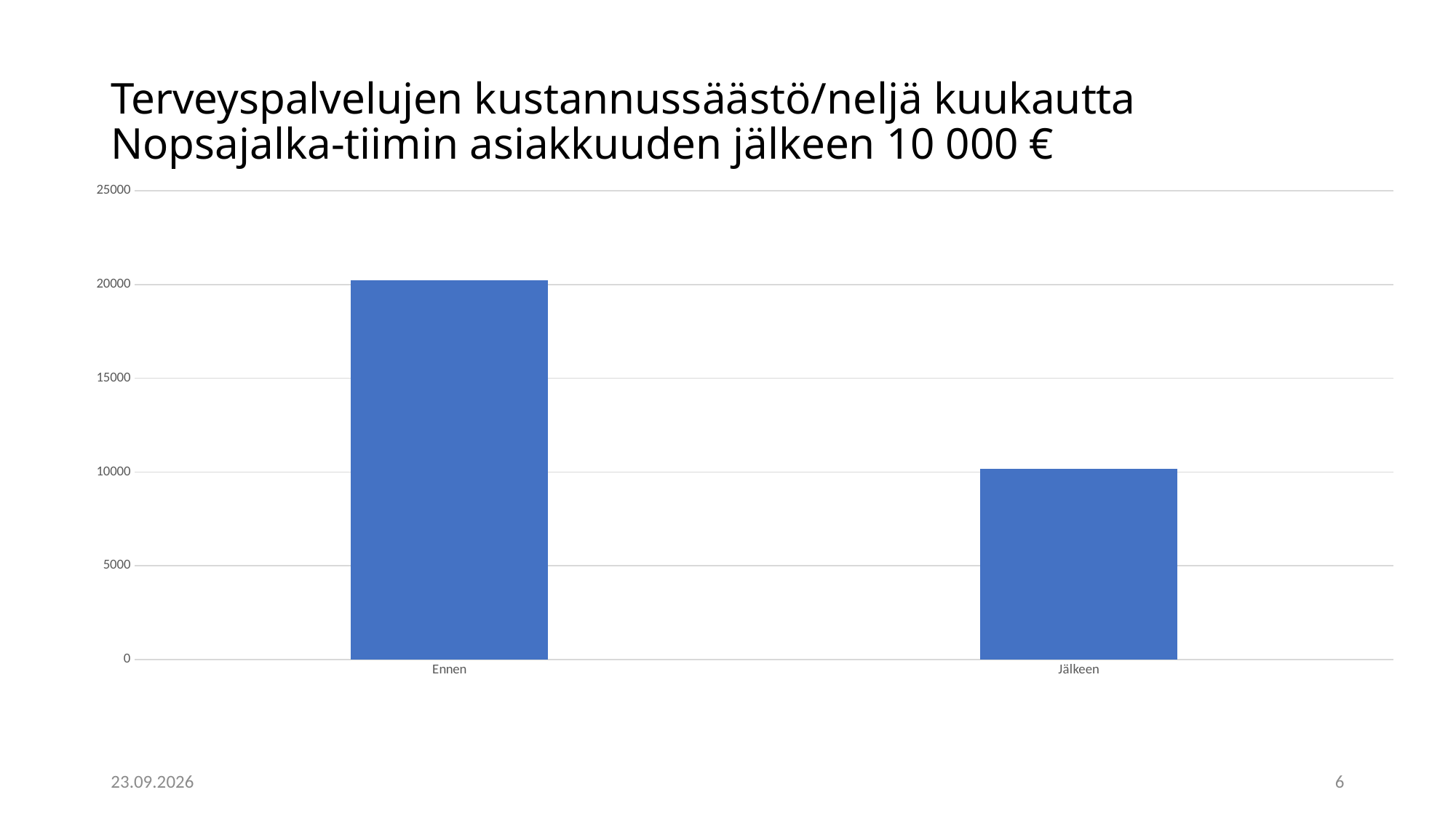
Which category has the highest bar in the chart? Ennen What kind of chart is shown on the slide? bar chart Is the value for Ennen greater or less than 25000? less Do the values rise or fall from Ennen to Jälkeen? fall What is the highest value shown on the vertical axis of the chart? 25000 Is the value for Jälkeen greater or less than 15000? less How many categories are shown on the x axis of the chart? 2 What is the label of the first category on the x axis? Ennen Which bar is taller, Ennen or Jälkeen? Ennen Is the value for Jälkeen greater or less than 5000? greater Which category has the lowest bar in the chart? Jälkeen